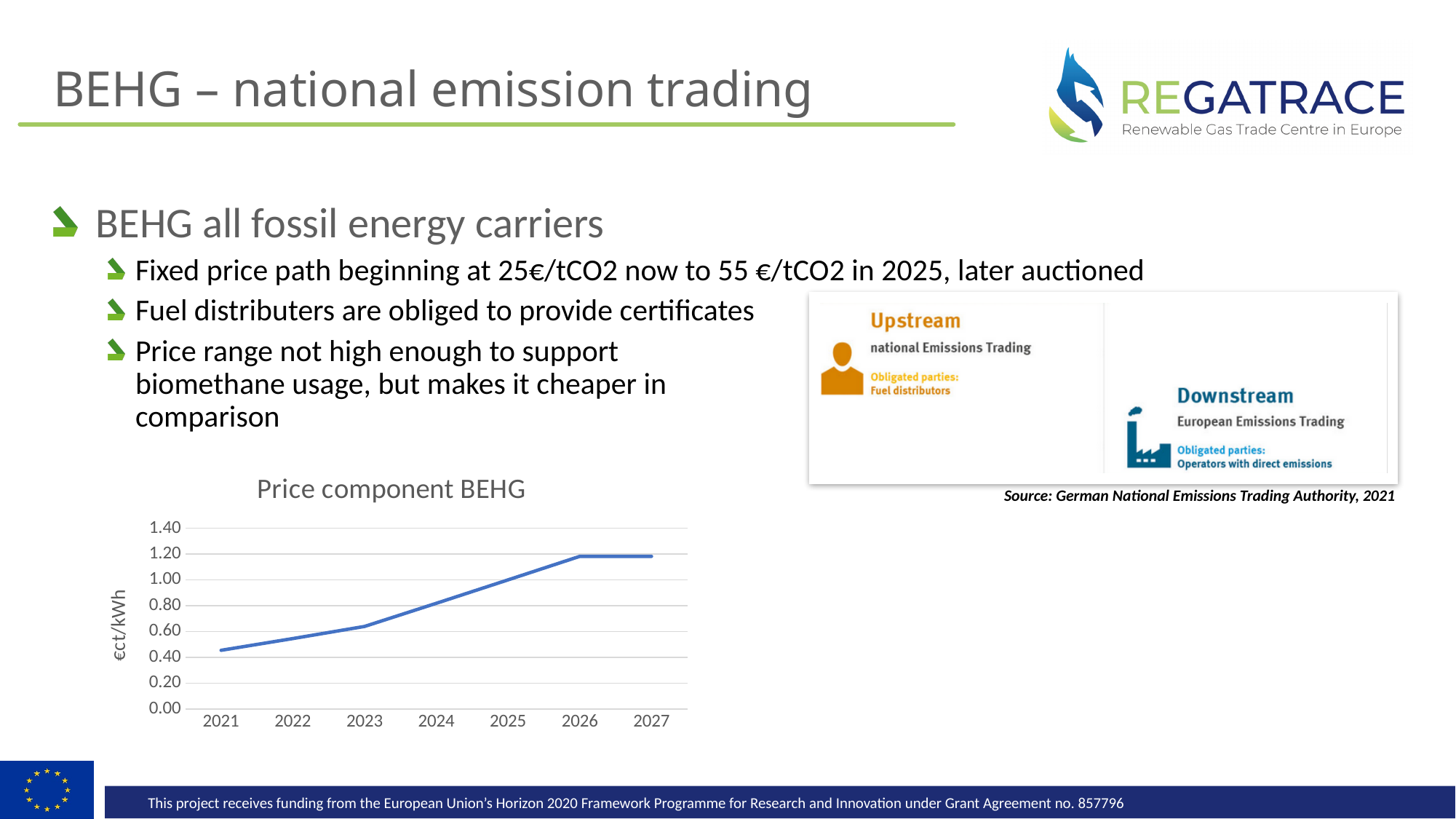
What kind of chart is 'Price component BEHG'? line chart Which year has the lowest value in the 'Price component BEHG' chart? 2021 What is the title of the chart on the slide? Price component BEHG Is the value for 2023 in the 'Price component BEHG' chart greater or less than 1.00? less What is the first year shown on the x-axis of the 'Price component BEHG' chart? 2021 What unit is shown on the y-axis of the 'Price component BEHG' chart? €ct/kWh Is the value for 2024 in the 'Price component BEHG' chart greater or less than 0.60? greater Does the line in the 'Price component BEHG' chart rise or fall from 2021 to 2026? rise In the 'Price component BEHG' chart, which is larger, the value for 2022 or the value for 2025? 2025 Is the value for 2026 in the 'Price component BEHG' chart greater or less than 1.00? greater How many years are plotted on the x-axis of the 'Price component BEHG' chart? 7